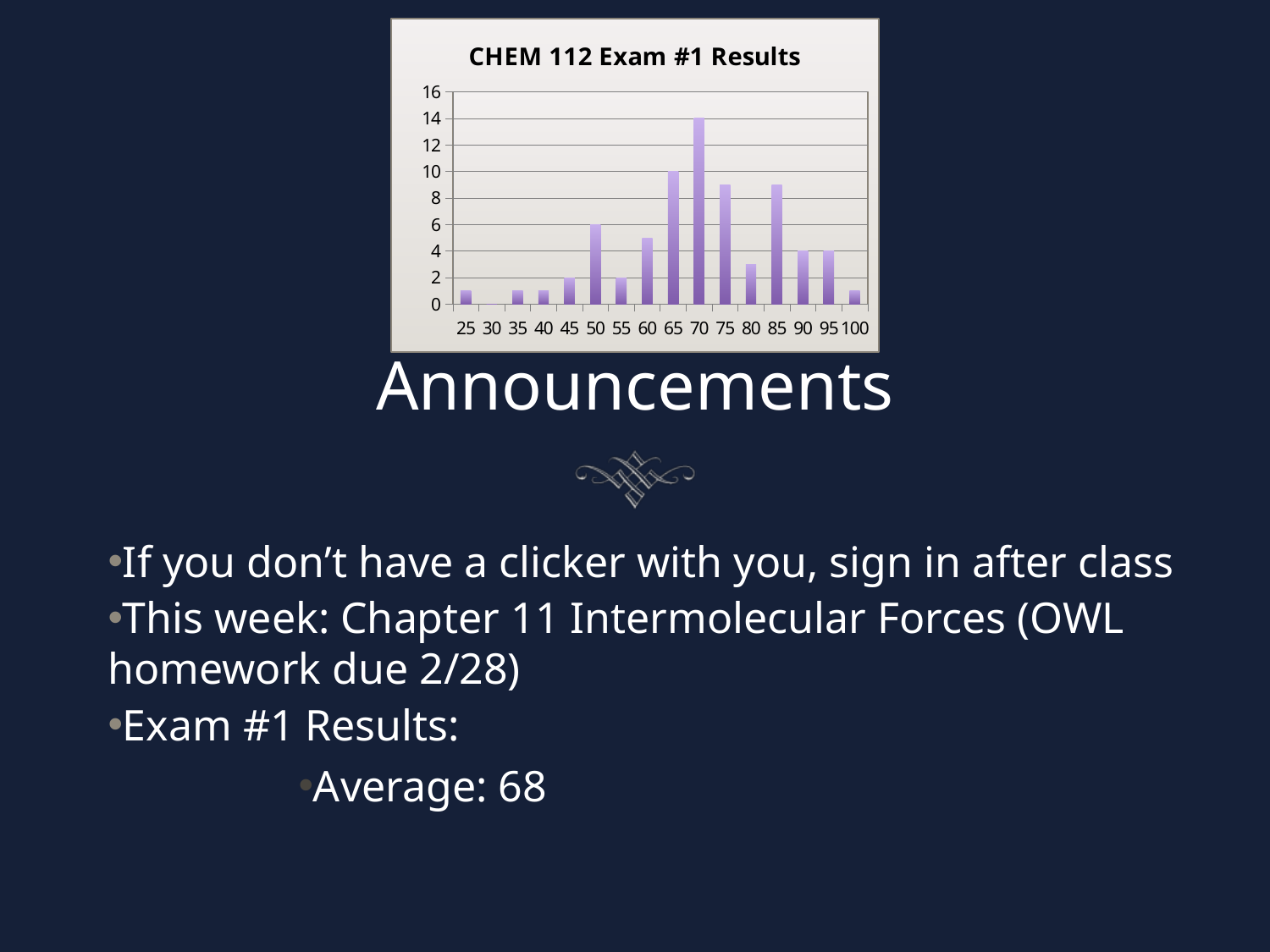
Is the value for 75 greater or less than 6? greater What is the value for the 90 category? 4 What is the value for the 50 category? 6 What is the difference between the values for 70 and 65? 4 Which is larger, the value for 70 or the value for 65? 70 How many score categories are shown on the x axis? 16 What is the value for the 70 category? 14 Which score category has the highest bar? 70 What is the value for the 65 category? 10 Is the value for 80 greater or less than 6? less What is the title of the chart? CHEM 112 Exam #1 Results What kind of chart is shown on the slide? bar chart